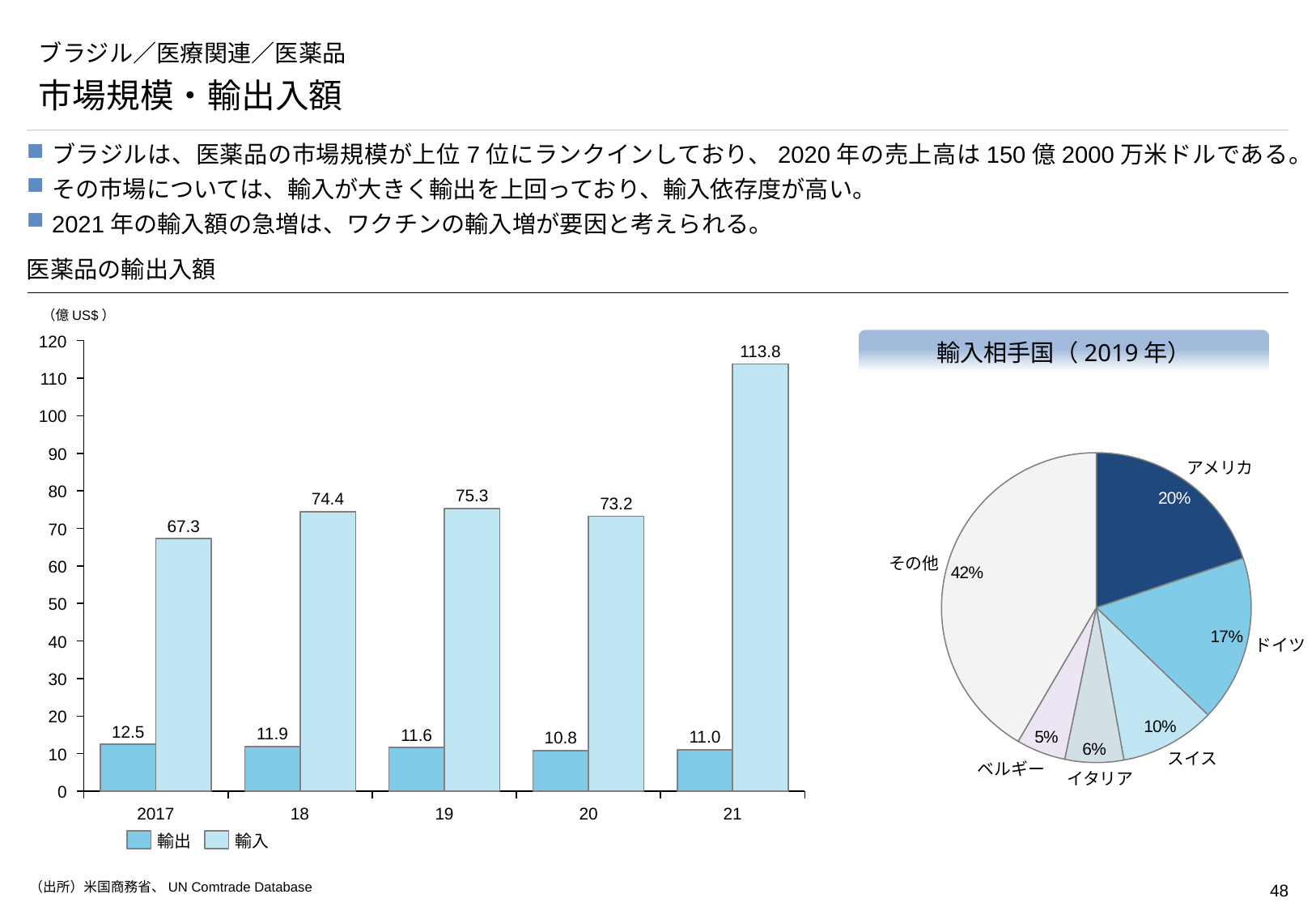
In the bar chart 医薬品の輸出入額, how many series does the legend list? 2 In the bar chart 医薬品の輸出入額, which year has the lowest 輸出 value? 20 In the bar chart 医薬品の輸出入額, what is the 輸出 value for 2017? 12.5 In the pie chart 輸入相手国（2019年）, which named country has the largest share? アメリカ In the bar chart 医薬品の輸出入額, how many years are shown on the x axis? 5 In the bar chart 医薬品の輸出入額, which year has the highest 輸入 value? 21 In the bar chart 医薬品の輸出入額, what is the 輸入 value for 2021? 113.8 What kind of chart is the chart titled 輸入相手国（2019年）? Pie chart In the bar chart 医薬品の輸出入額, what is the difference between the 輸入 values for 2021 and 2020? 40.6 In the pie chart 輸入相手国（2019年）, what share does ドイツ have? 17% In the pie chart 輸入相手国（2019年）, what is the difference between the shares of スイス and ベルギー? 5% In the bar chart 医薬品の輸出入額, is the 輸入 value for 2019 larger than the 輸入 value for 2018? Yes